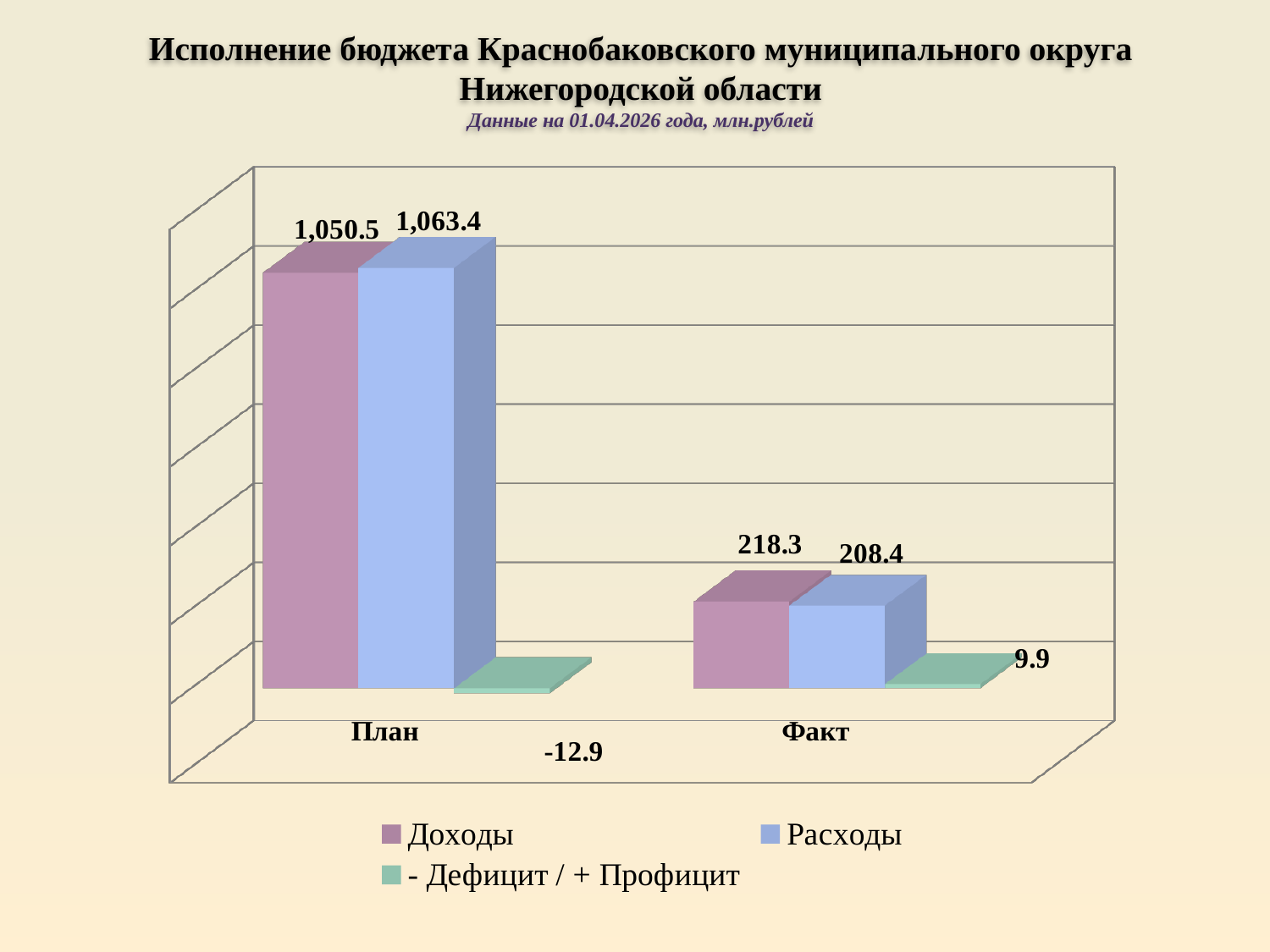
What is the difference between Расходы and Доходы for План? 12.9 How many categories are shown on the x axis? 2 What is the value of Расходы for Факт? 208.4 How many series does the legend list? 3 What is the difference between Доходы for План and Доходы for Факт? 832.2 What is the value of Расходы for План? 1,063.4 What is the value of - Дефицит / + Профицит for План? -12.9 What is the value of Доходы for План? 1,050.5 Which is larger for Факт, Доходы or Расходы? Доходы What is the value of - Дефицит / + Профицит for Факт? 9.9 What is the value of Доходы for Факт? 218.3 What kind of chart is shown on the slide? Bar chart